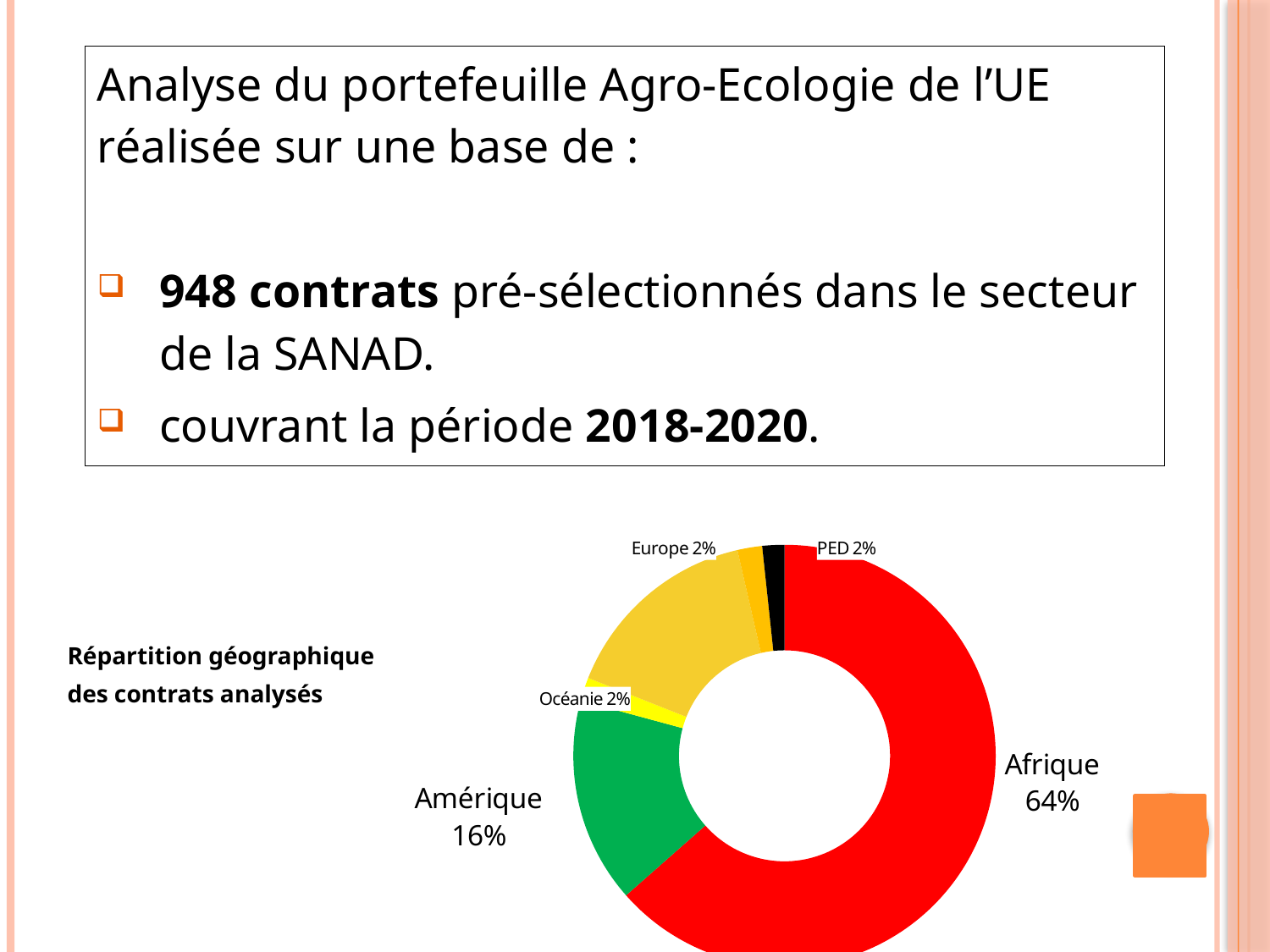
What share of the analysed contracts is for Afrique? 64% What percentage is shown for PED? 2% Which region has the largest share of the analysed contracts? Afrique What is the difference in percentage points between the Afrique share and the Amérique share? 48% Which is larger, the share for Amérique or the share for Océanie? Amérique What percentage is shown for Océanie? 2% What share of the analysed contracts is for Amérique? 16% What is the title of the chart? Répartition géographique des contrats analysés What percentage is shown for Europe? 2% What colour is the Afrique slice of the chart? red Which is larger, the share for Afrique or the share for Amérique? Afrique What kind of chart is shown on the slide? doughnut chart